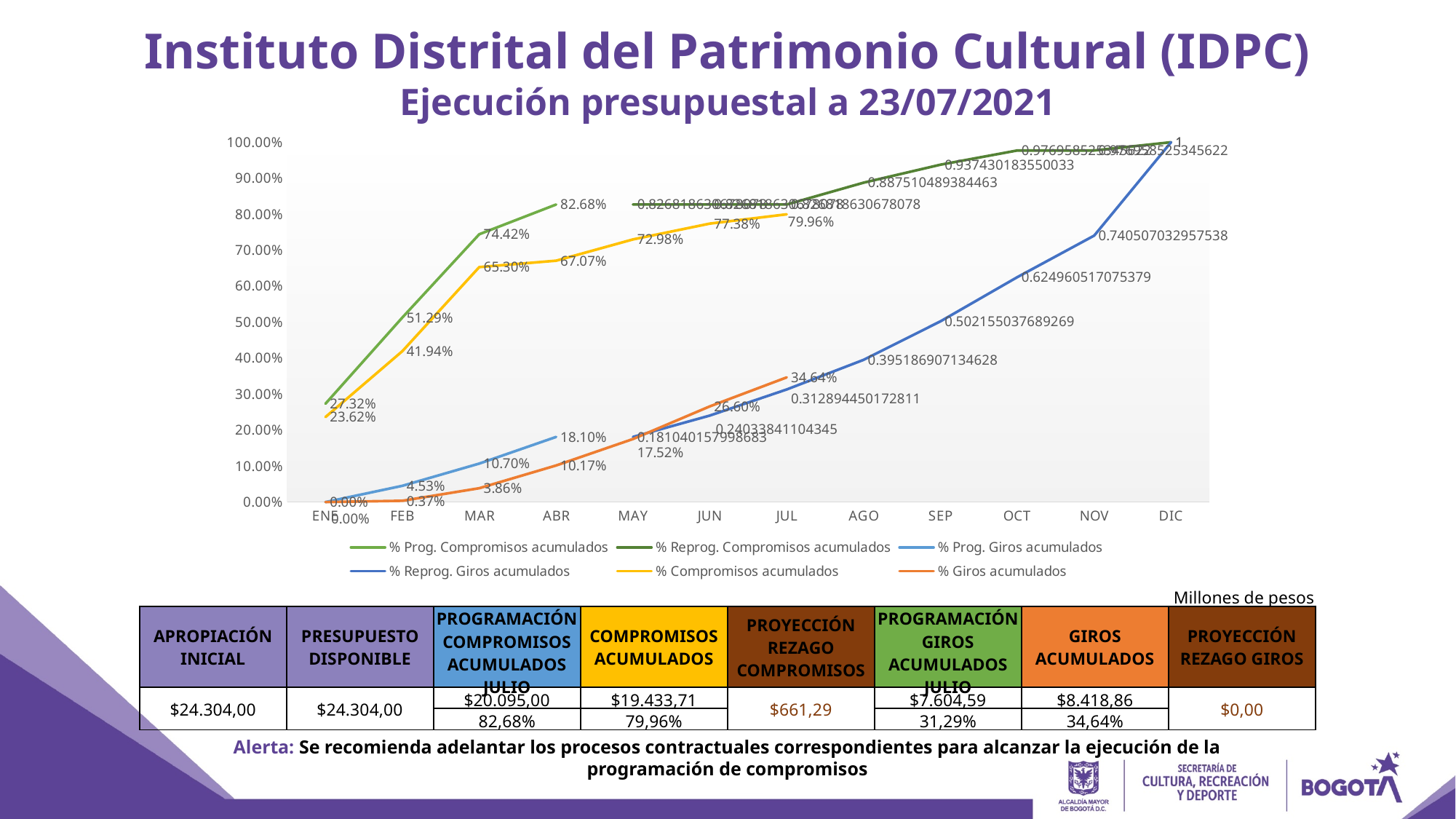
What kind of chart is shown on the slide? line chart In MAR, which is higher: % Prog. Compromisos acumulados or % Compromisos acumulados? % Prog. Compromisos acumulados What is the value of % Prog. Giros acumulados in ABR? 18.10% What is the value of % Giros acumulados in FEB? 0.37% How many series does the chart legend list? 6 Does % Giros acumulados rise or fall from ENE to JUL? rises What is the value of % Giros acumulados in JUL? 34.64% What is the difference between % Prog. Compromisos acumulados and % Compromisos acumulados in MAR? 9.12% How many months are shown on the x axis of the chart? 12 What is the value of % Compromisos acumulados in JUL? 79.96% Is the value of % Reprog. Giros acumulados in NOV greater or less than 70.00%? greater What is the value of % Prog. Compromisos acumulados in ABR? 82.68%